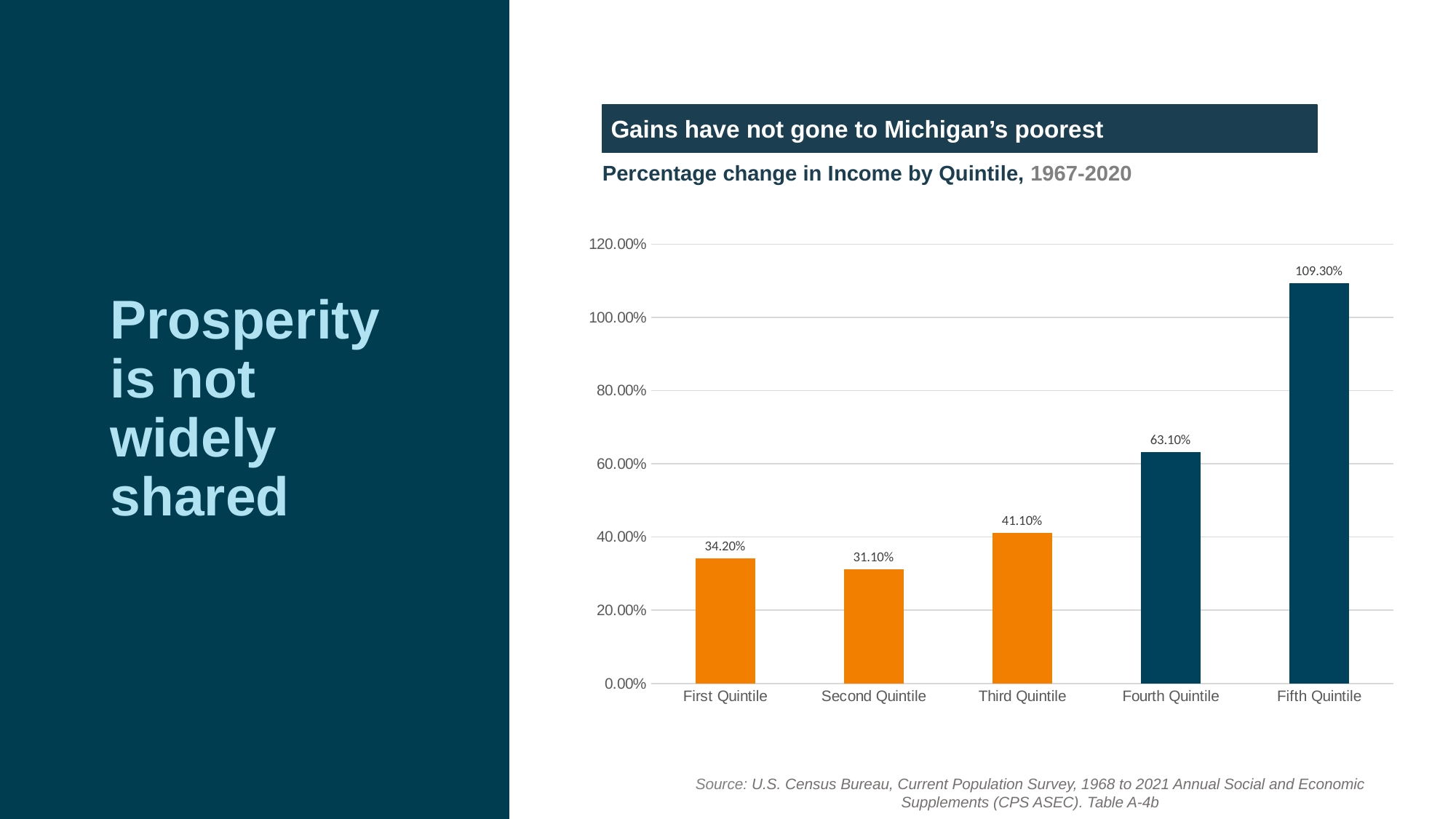
How many quintiles are shown on the chart? 5 What is the value shown for the Third Quintile? 41.10% What is the percentage change in income for the Fifth Quintile? 109.30% Which quintile has the lowest percentage change in income? Second Quintile Which is larger, the value for the First Quintile or the Third Quintile? Third Quintile What time period does the chart subtitle cover? 1967-2020 What is the difference between the First Quintile and Second Quintile values? 3.10% What is the percentage change in income for the Second Quintile? 31.10% What is the difference between the Fifth Quintile and the Fourth Quintile values? 46.20% Which quintile has the highest percentage change in income? Fifth Quintile Is the value for the Fourth Quintile greater or less than 60.00%? greater What kind of chart is shown on the slide? Bar chart